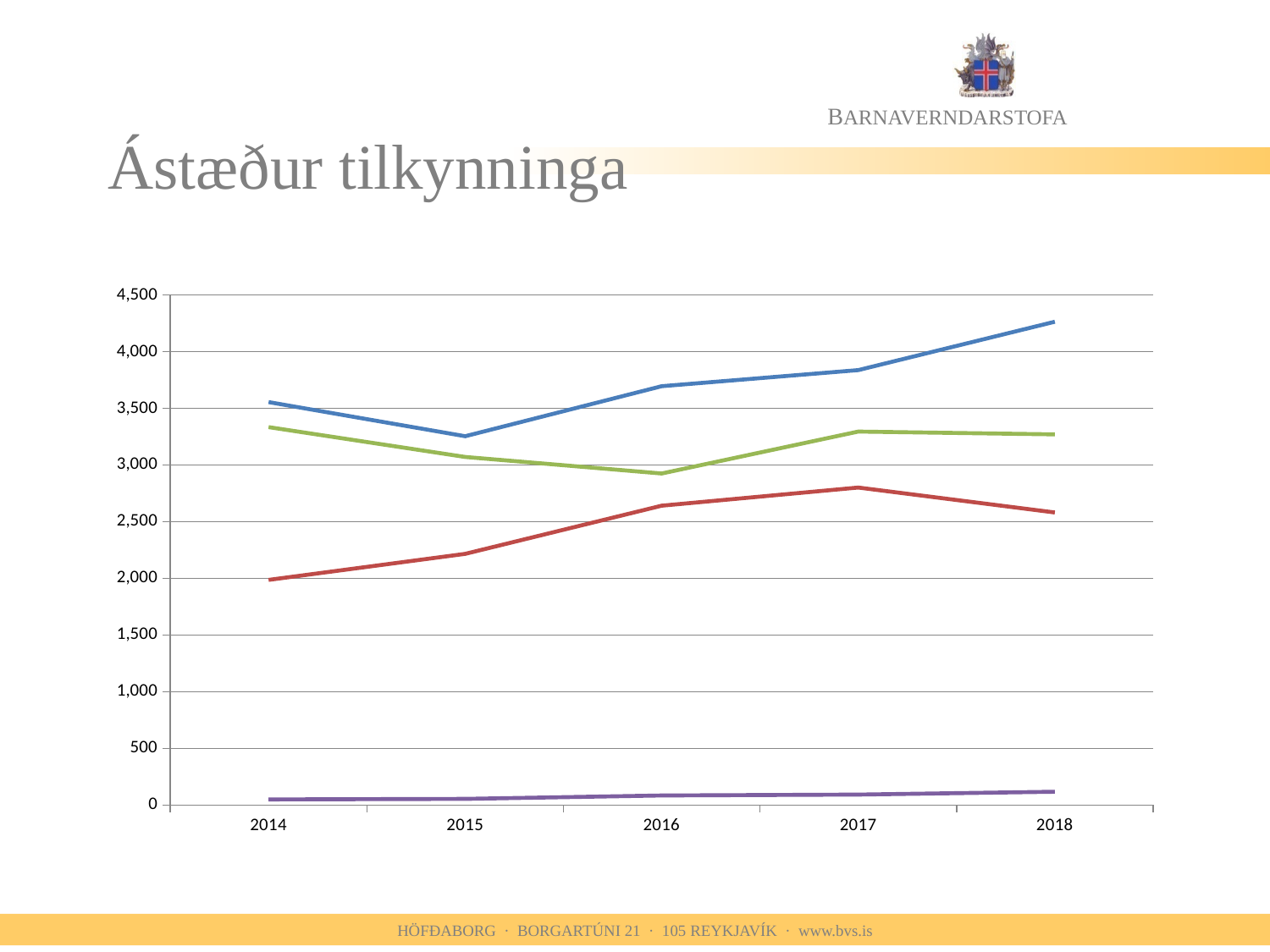
In which year does the blue line reach its highest value? 2018 Which line has the highest value in 2018? the blue line Does the blue line rise or fall from 2015 to 2018? rise Which line has the lowest value across all years? the purple line How many lines are plotted on the chart? 4 In which year does the blue line reach its lowest value? 2015 How many years are shown on the x axis of the chart? 5 In which year does the red line reach its highest value? 2017 What is the title of the slide containing the chart? Ástæður tilkynninga What kind of chart is shown on the slide? line chart Is the value of the red line in 2017 greater or less than 2,500? greater Is the value of the blue line in 2018 greater or less than 4,000? greater